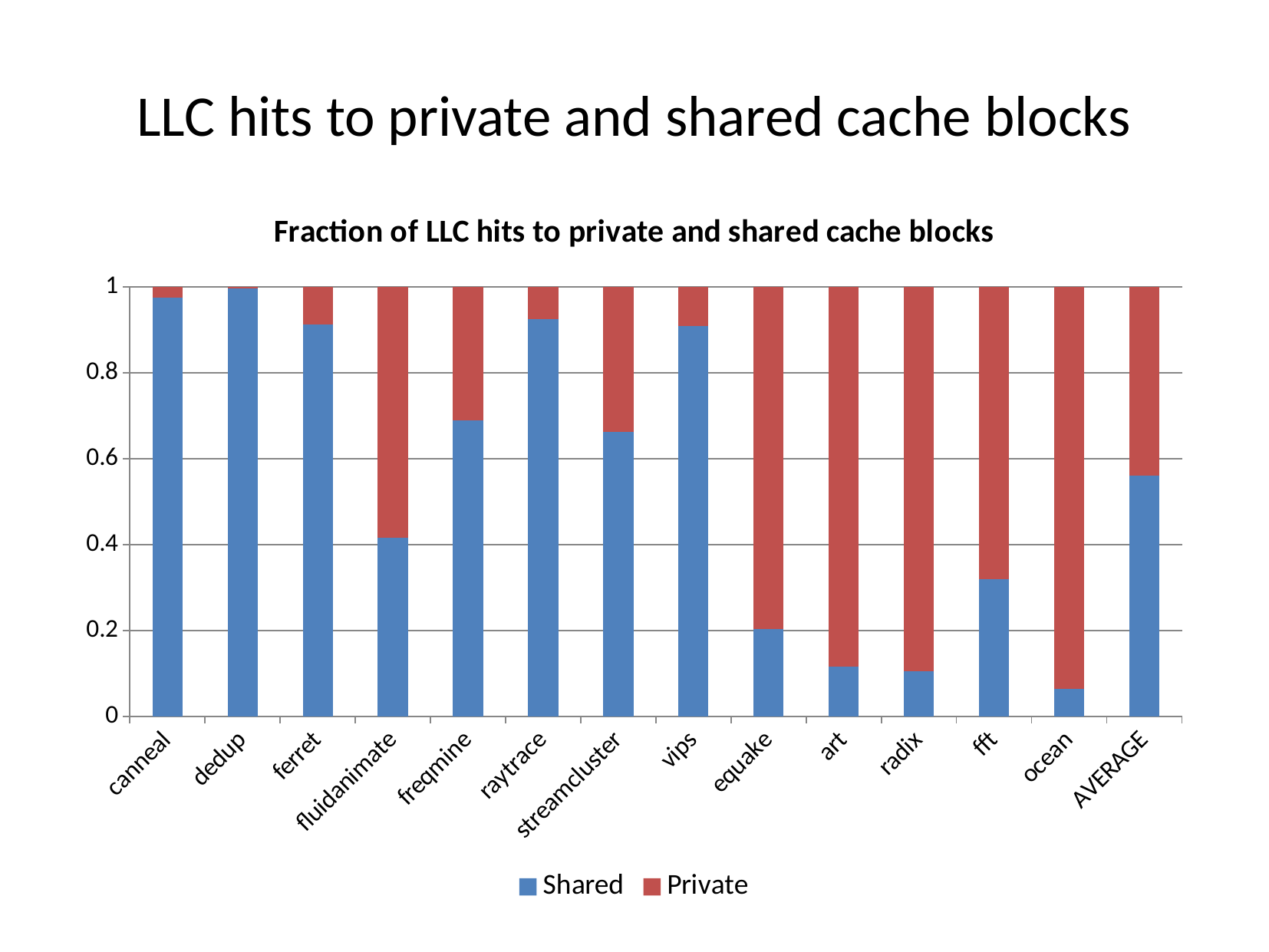
Is the Shared value for fft greater or less than 0.4? less Is the Shared value for AVERAGE greater or less than 0.4? greater What kind of chart is shown on the slide? Stacked bar chart Which category has the largest Private fraction? ocean How many categories are shown along the x axis? 14 What is the total height of the stacked bar for AVERAGE? 1 What is the title of the chart? Fraction of LLC hits to private and shared cache blocks Which has the larger Shared fraction, fluidanimate or freqmine? freqmine Which category has the lowest Shared fraction? ocean Is the Shared value for equake greater or less than 0.4? less How many series does the legend list? 2